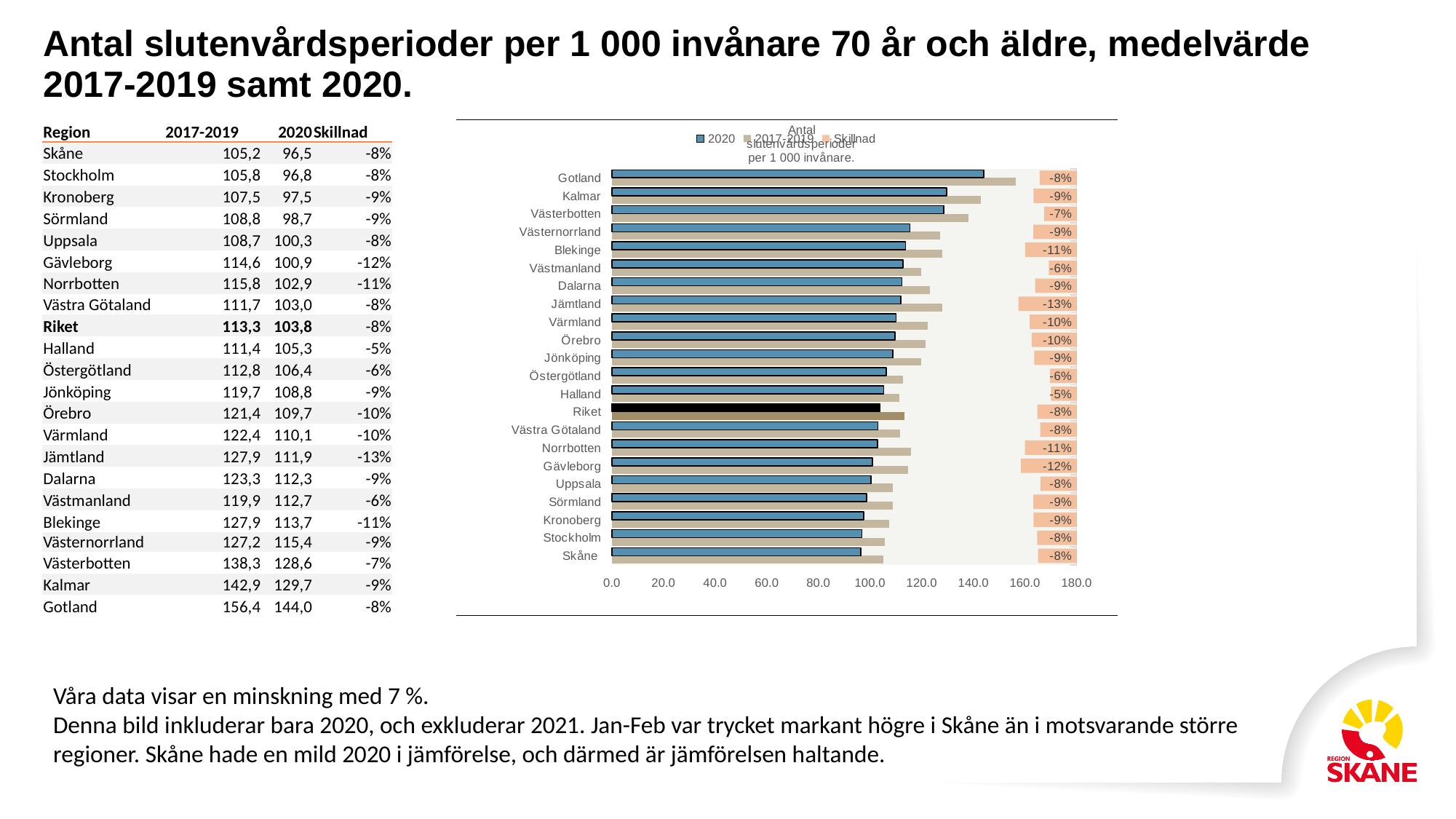
Is the 2020 value for Halland greater or less than 120? less Which is larger, the 2020 value for Kalmar or the 2020 value for Skåne? Kalmar Which region has the largest percentage decrease (Skillnad) on the chart? Jämtland What is the Skillnad value shown for Jämtland on the chart? -13% Which region has the smallest percentage decrease (Skillnad) on the chart? Halland Which region has the highest 2020 value on the chart? Gotland How many series does the chart legend list? 3 How many regions (including Riket) are plotted on the chart? 22 What kind of chart is shown on the slide? Bar chart Is the 2017-2019 value for Gotland greater or less than 140? greater What is the Skillnad value shown for Riket on the chart? -8% What is the Skillnad value shown for Halland on the chart? -5%